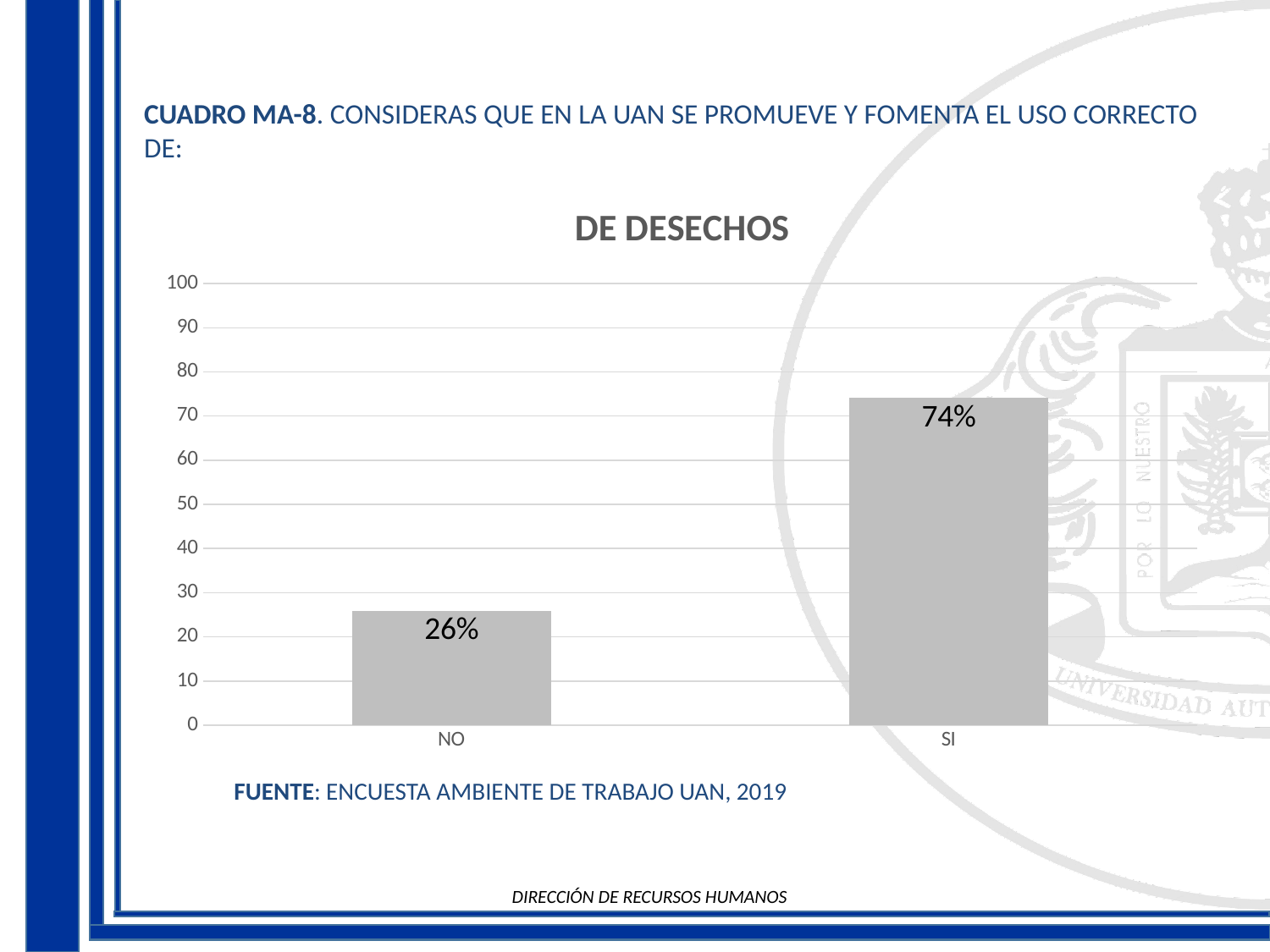
What is the title of the chart? DE DESECHOS Which category has the lowest value? NO What is the value for SI? 74% What is the value for NO? 26% Which category has the highest value? SI Which is larger, the value for NO or the value for SI? SI Is the value for NO greater or less than 30? less What is the maximum value shown on the y axis? 100 Is the value for SI greater or less than 70? greater What kind of chart is shown? bar chart What is the difference between the values for SI and NO? 48% How many categories are shown on the x axis? 2